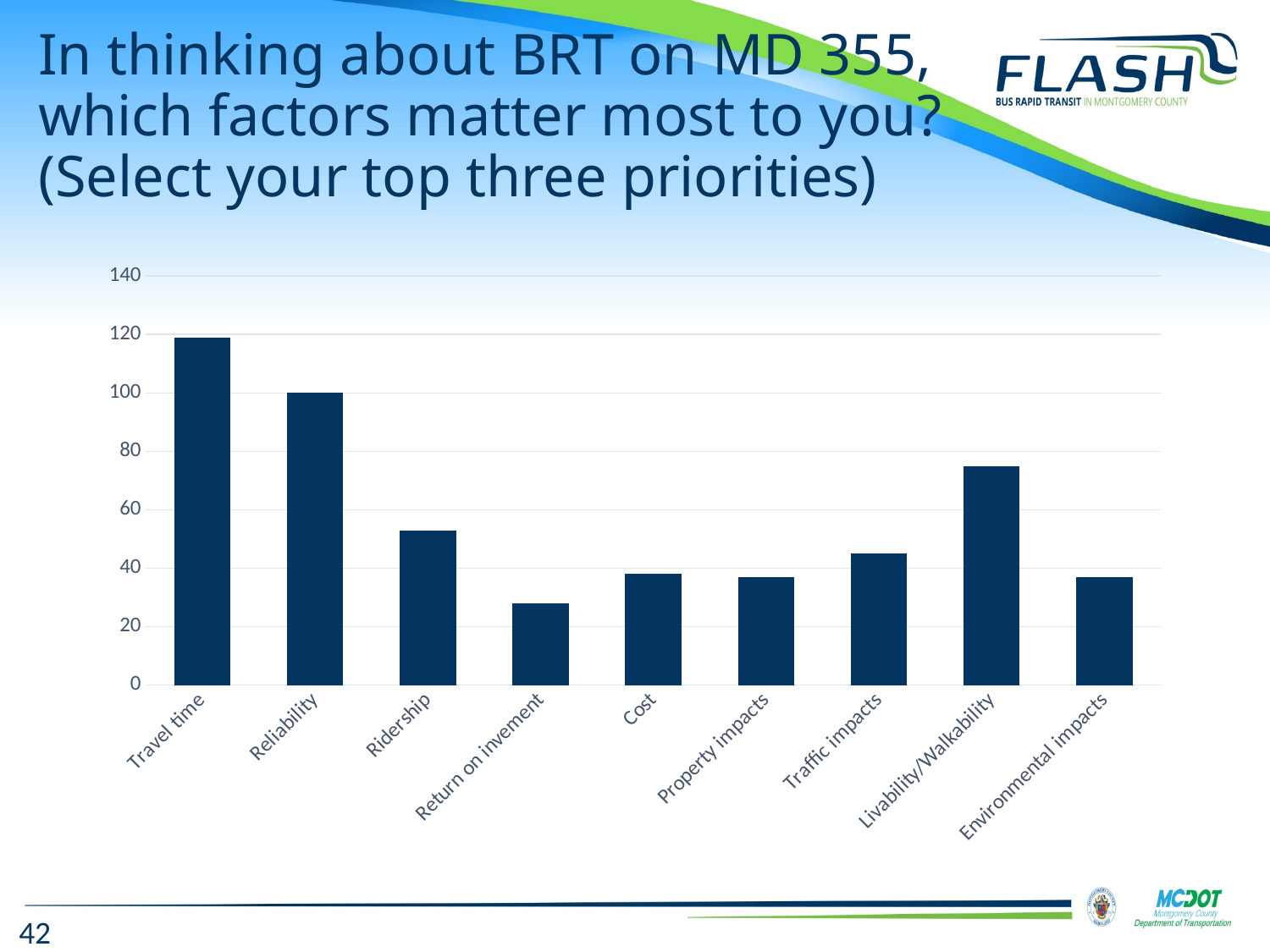
Is the value for Ridership greater or less than 40? greater Which has a larger value, Livability/Walkability or Ridership? Livability/Walkability Is the value for Travel time greater or less than 100? greater What is the highest value shown on the vertical axis of the chart? 140 Which factor has the lowest value in the chart? Return on invement Which has a larger value, Traffic impacts or Return on invement? Traffic impacts How many categories (factors) are shown on the x axis of the chart? 9 What kind of chart is shown on the slide? bar chart Which factor has the highest value in the chart? Travel time Is the value for Return on invement greater or less than 40? less Which has a larger value, Travel time or Reliability? Travel time